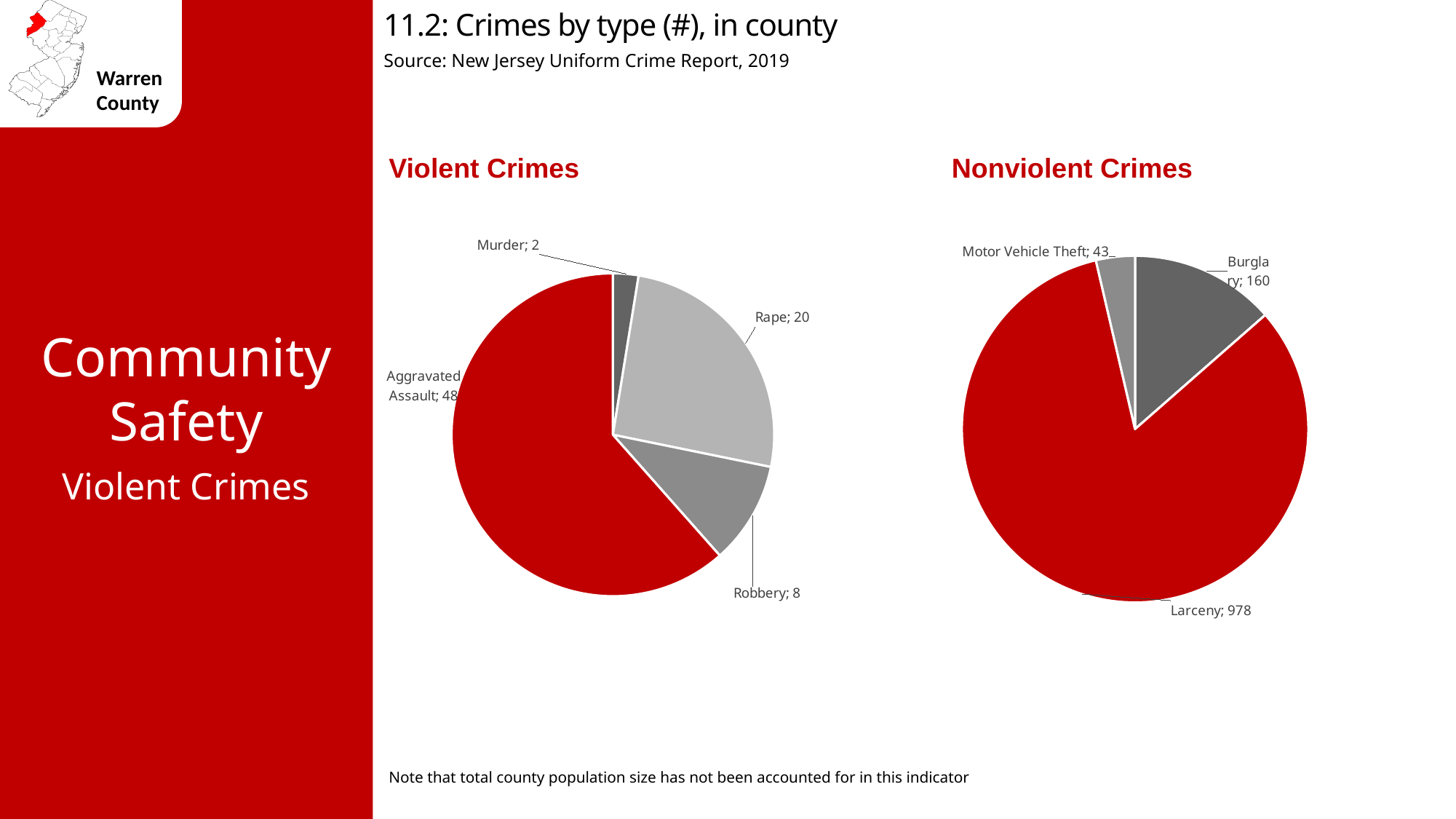
In the Violent Crimes chart, which crime type has the smallest slice? Murder In the Violent Crimes chart, which crime type has the largest slice? Aggravated Assault What type of chart is used for Nonviolent Crimes? Pie chart In the Nonviolent Crimes chart, which is larger, Burglary or Motor Vehicle Theft? Burglary In the Violent Crimes chart, what is the difference between Rape and Robbery? 12 In the Nonviolent Crimes chart, what is the value for Burglary? 160 In the Nonviolent Crimes chart, which crime type has the largest slice? Larceny In the Nonviolent Crimes chart, what is the difference between Larceny and Burglary? 818 In the Violent Crimes chart, what is the value for Aggravated Assault? 48 How many categories are shown in the Violent Crimes chart? 4 In the Nonviolent Crimes chart, what is the value for Motor Vehicle Theft? 43 In the Violent Crimes chart, how many murders are shown? 2